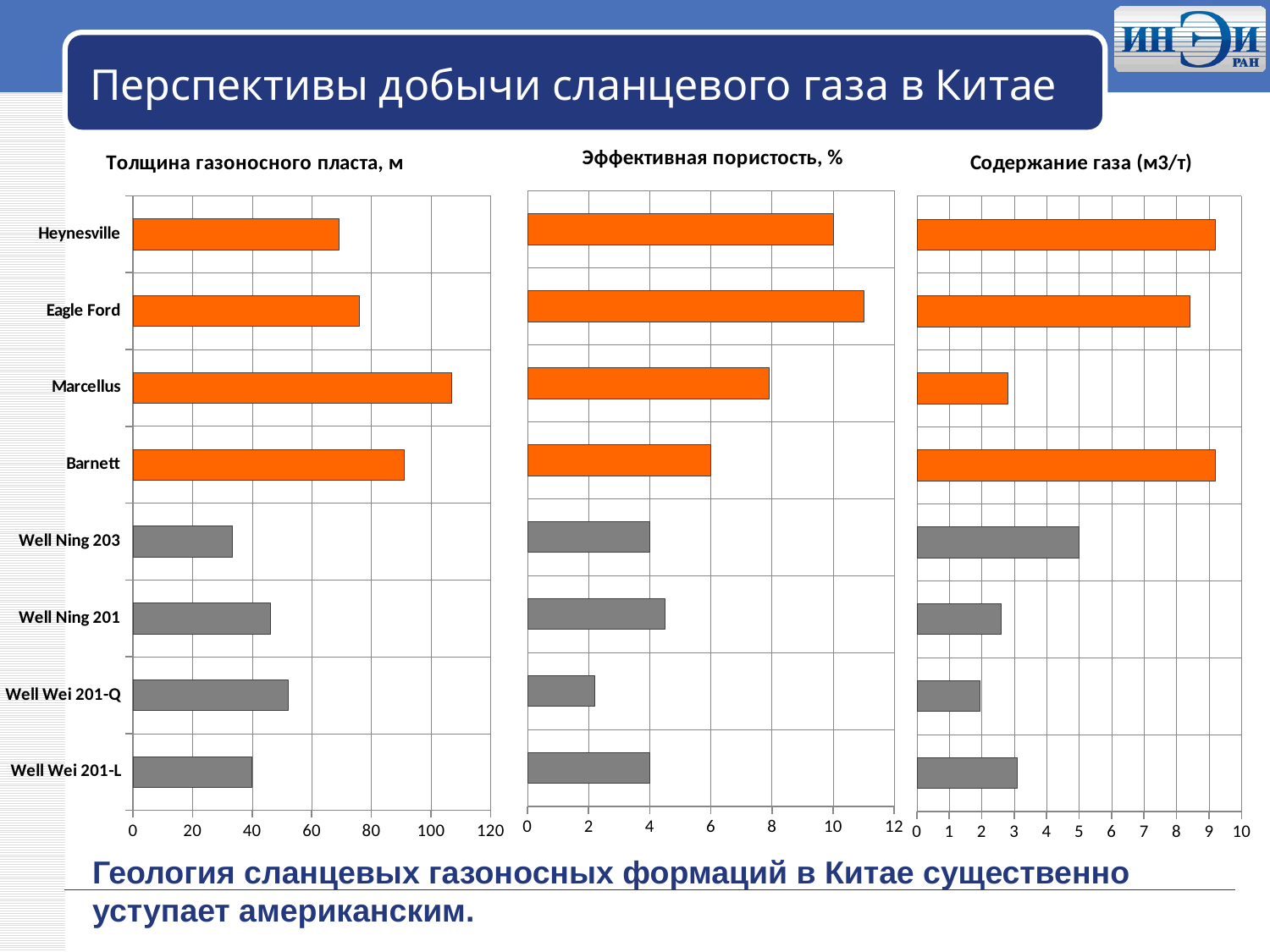
In the "Содержание газа (м3/т)" chart, which category has the lowest value? Well Wei 201-Q What kind of chart is the "Толщина газоносного пласта, м" chart? bar chart In the "Толщина газоносного пласта, м" chart, is the value for Well Wei 201-Q greater or less than 60? less In the "Толщина газоносного пласта, м" chart, which category has the lowest value? Well Ning 203 In the "Эффективная пористость, %" chart, which category has the lowest value? Well Wei 201-Q In the "Содержание газа (м3/т)" chart, is the value for Well Ning 203 greater or less than 4? greater In the "Толщина газоносного пласта, м" chart, which category has the highest value? Marcellus In the "Эффективная пористость, %" chart, is the value for Barnett greater or less than 4? greater In the "Содержание газа (м3/т)" chart, which is larger, the value for Eagle Ford or the value for Marcellus? Eagle Ford In the "Эффективная пористость, %" chart, which category has the highest value? Eagle Ford How many categories are shown in the "Эффективная пористость, %" chart? 8